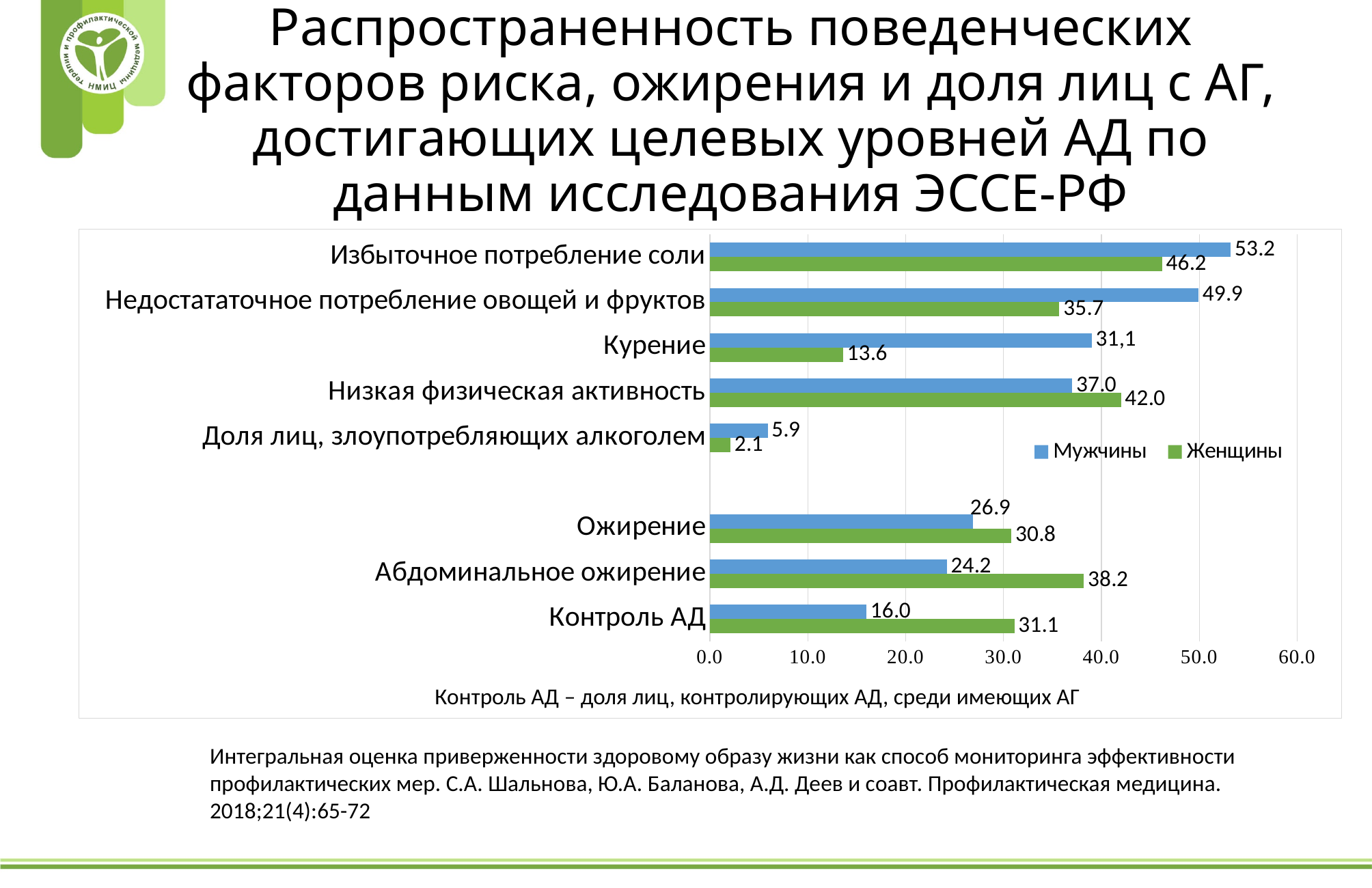
How many labeled categories are shown on the chart? 8 Which category has the highest value for Мужчины? Избыточное потребление соли What is the difference between the Женщины and Мужчины values for Контроль АД? 15.1 Which category has the lowest value for Женщины? Доля лиц, злоупотребляющих алкоголем For Низкая физическая активность, which series has the larger value, Мужчины or Женщины? Женщины What type of chart is shown on the slide? bar chart What is the value for Женщины for Абдоминальное ожирение? 38.2 Which colour represents the Женщины series in the chart? green How many series does the chart legend list? 2 What is the value for Мужчины for Контроль АД? 16.0 What is the value for Женщины for Курение? 13.6 What is the value for Мужчины for Избыточное потребление соли? 53.2